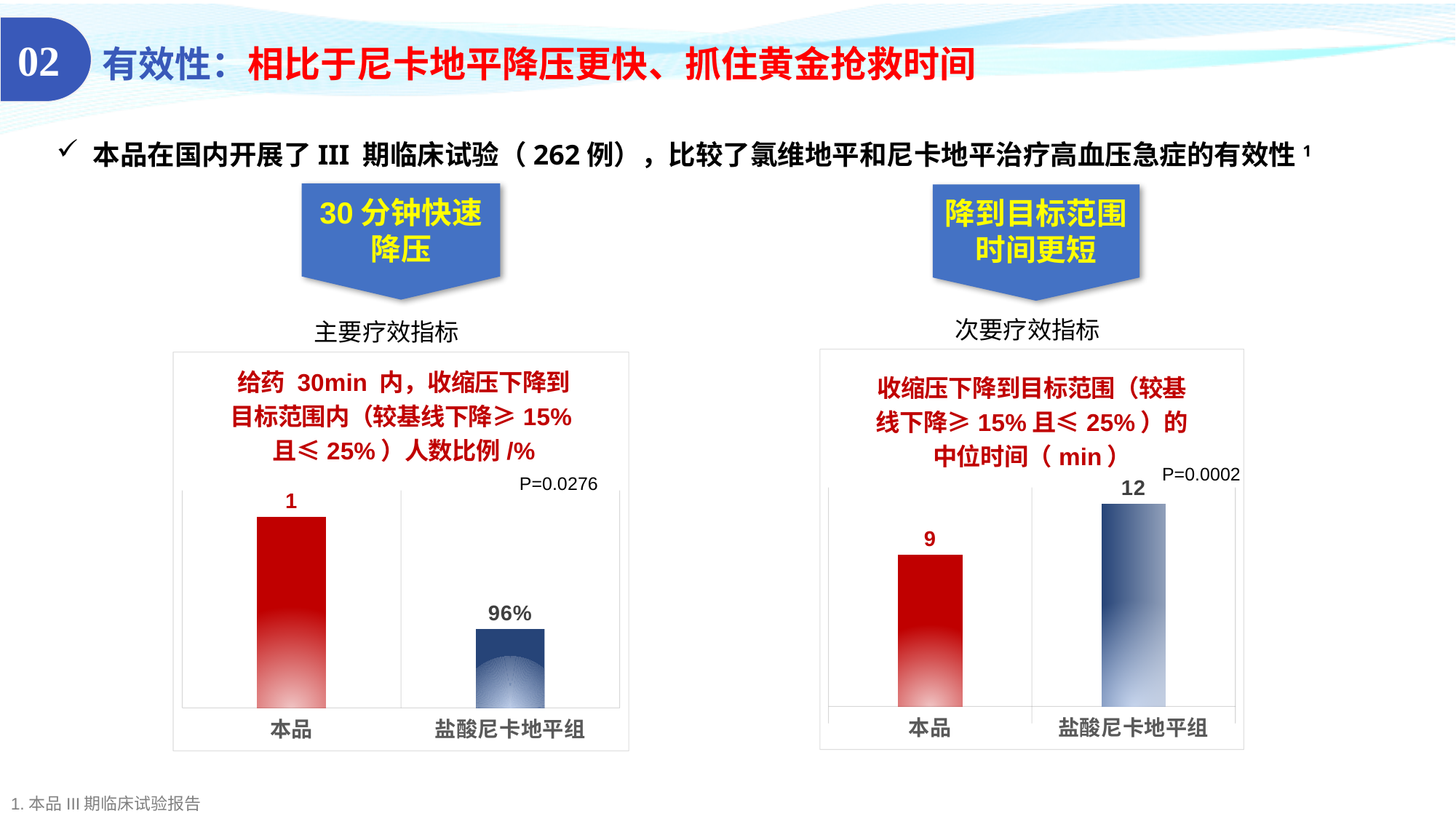
What P value is printed on the left chart (主要疗效指标)? P=0.0276 In the right chart (次要疗效指标), which group has the lower value? 本品 In the left chart (主要疗效指标), what is the value shown for 盐酸尼卡地平组? 96% In the right chart (次要疗效指标), what is the value shown for 盐酸尼卡地平组? 12 In the right chart (次要疗效指标), what is the value shown for 本品? 9 How many bars are shown in the left chart (主要疗效指标)? 2 What P value is printed on the right chart (次要疗效指标)? P=0.0002 In the left chart (主要疗效指标), what is the value shown for 本品? 1 In the right chart (次要疗效指标), which group has the higher value? 盐酸尼卡地平组 In the right chart (次要疗效指标), what is the difference between the values for 盐酸尼卡地平组 and 本品? 3 In the left chart (主要疗效指标), which bar is taller, 本品 or 盐酸尼卡地平组? 本品 What type of chart is the right chart (次要疗效指标)? Bar chart